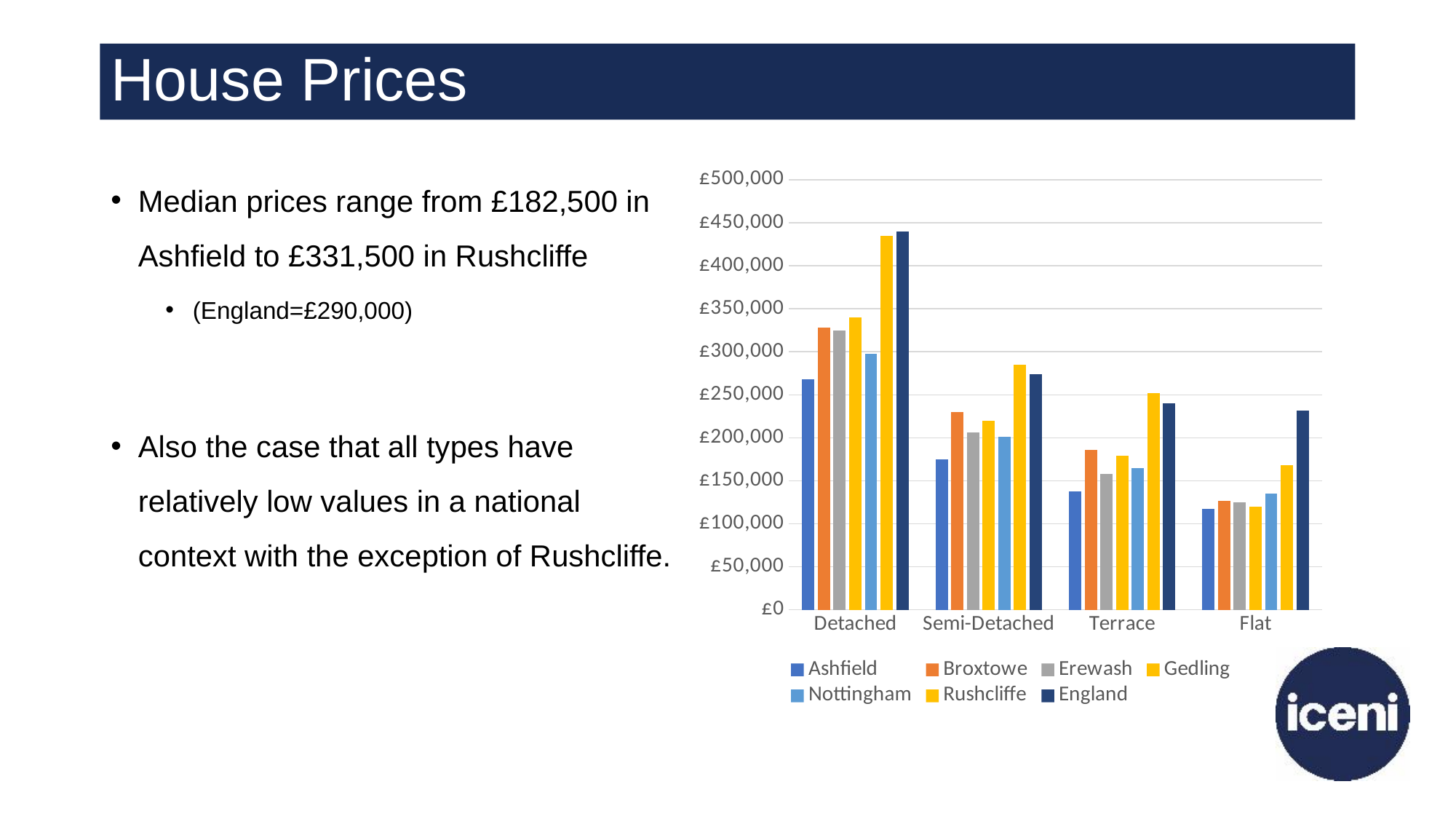
What kind of chart is shown on the slide? bar chart Which series has the highest value for Flat? England For Terrace, which is larger: the value for Rushcliffe or the value for England? Rushcliffe Do the values for Ashfield rise or fall moving from Detached to Flat along the x axis? fall Is the value for Rushcliffe in the Detached category greater or less than £400,000? greater How many series does the chart's legend list? 7 Is the value for England in the Flat category greater or less than £200,000? greater How many property type categories are shown on the x axis of the chart? 4 For Terrace, which is larger: the value for Ashfield or the value for Broxtowe? Broxtowe Which series has the lowest value for Detached? Ashfield Is the value for Gedling in the Detached category greater or less than £300,000? greater